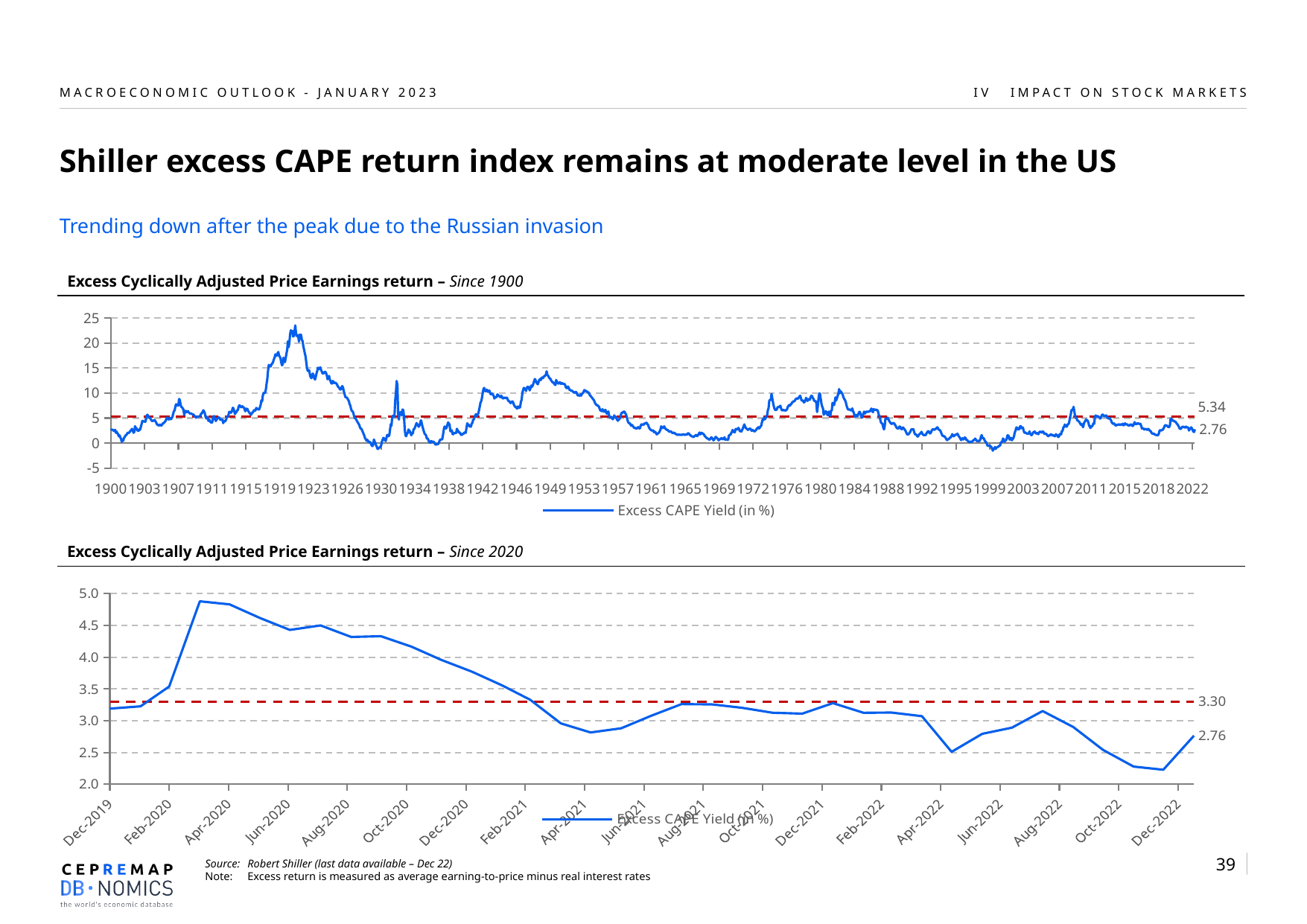
In the 'Since 1900' chart, what is the difference between the dashed line value and the final labelled value of the blue line? 2.58 In the 'Since 2020' chart, what is the value labelled at the end of the blue line for Dec-2022? 2.76 In the 'Since 2020' chart, is the value for Apr-2020 greater or less than 4.5? greater In the 'Since 2020' chart, what value is labelled on the red dashed horizontal line? 3.30 How many series does the legend of the 'Since 1900' chart list? 1 What kind of chart is the 'Since 2020' chart? Line chart In the 'Since 2020' chart, which labelled month has the highest value? Apr-2020 In the 'Since 1900' chart, what value is labelled on the red dashed horizontal line? 5.34 What is the legend entry shown below the 'Since 1900' chart? Excess CAPE Yield (in %) In the 'Since 2020' chart, what is the difference between the dashed line value and the final labelled value of the blue line? 0.54 In the 'Since 2020' chart, do the values rise or fall between Apr-2020 and Feb-2021? Fall In the 'Since 1900' chart, what is the value labelled at the end of the blue line in 2022? 2.76